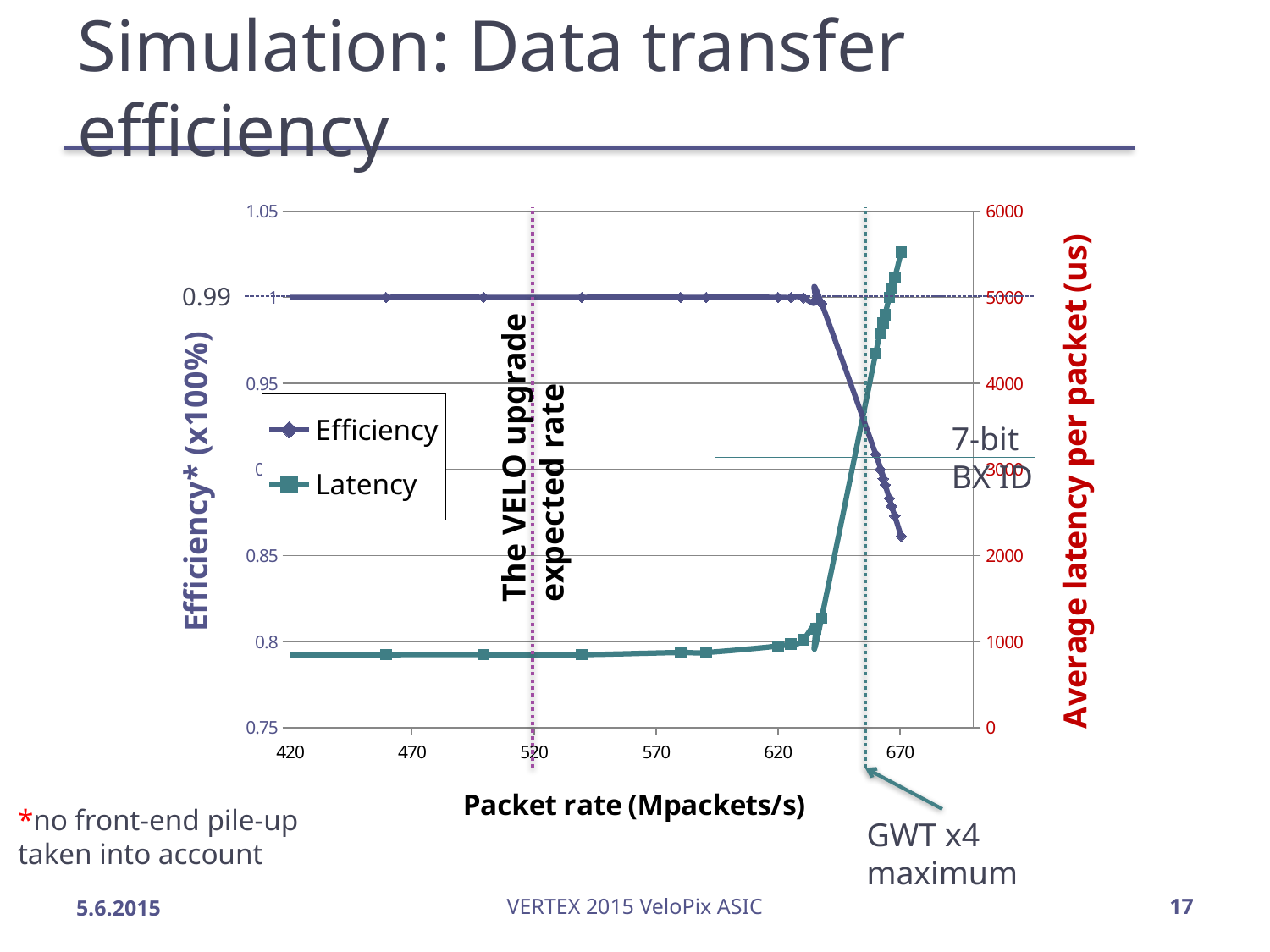
Does the Latency series rise or fall as the packet rate increases beyond about 620 Mpackets/s? rise What are the two series named in the chart legend? Efficiency and Latency Is the lowest Efficiency value plotted (at about 670 Mpackets/s) greater or less than 0.9? less What is the title of the x axis of the chart? Packet rate (Mpackets/s) How many series does the chart legend list? 2 Is the Efficiency value at a packet rate of 420 Mpackets/s greater or less than 0.95? greater Which series, Efficiency or Latency, has the larger value on its own axis at a packet rate of 520 Mpackets/s relative to the axis maximum, i.e. which series is plotted higher on the chart at 520? Efficiency Is the highest Latency value plotted (at about 670 Mpackets/s) greater or less than 5000 us? greater What kind of chart is shown on the slide? line chart Does the Efficiency series rise or fall as the packet rate increases beyond about 640 Mpackets/s? fall